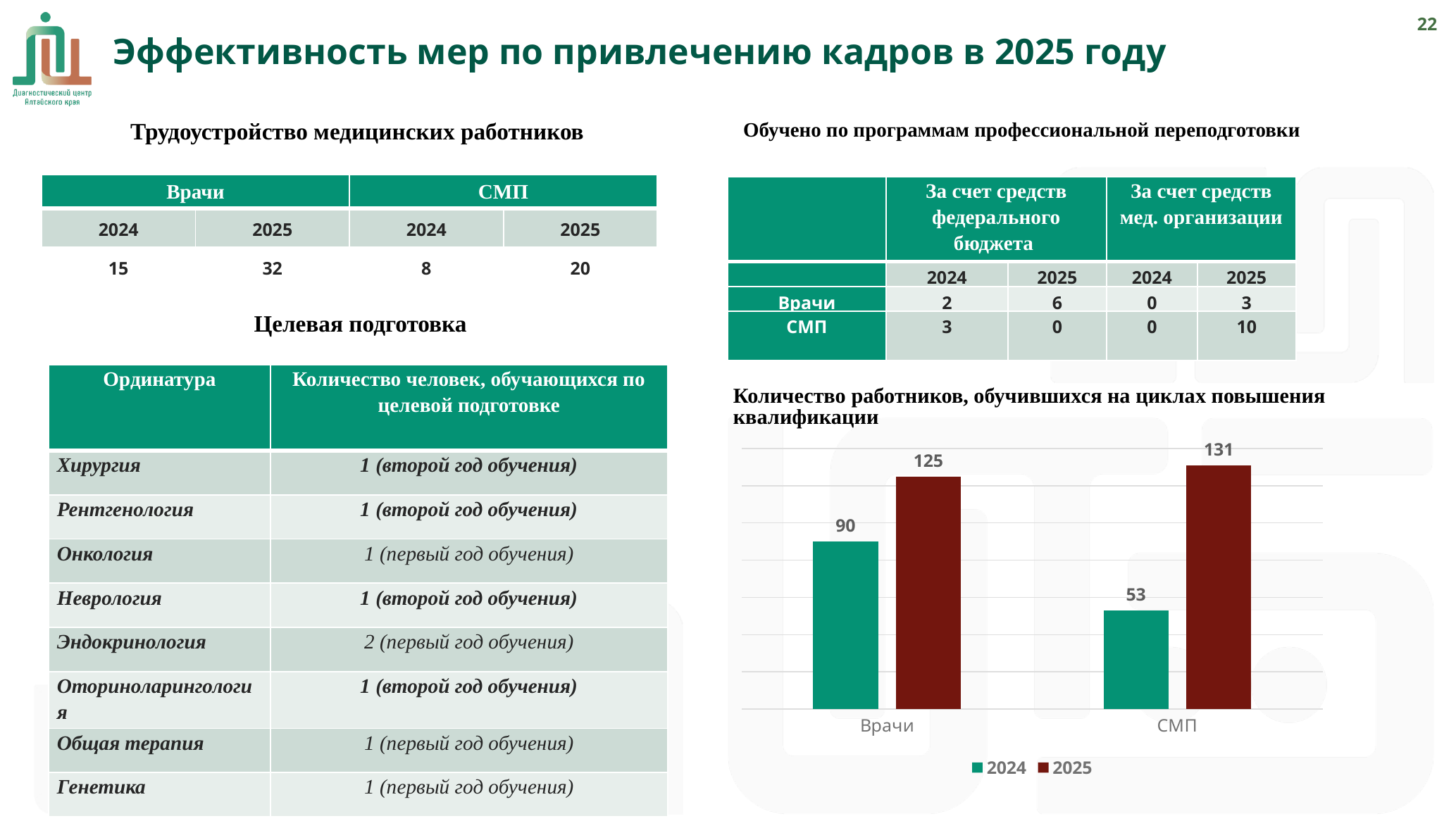
What is the difference between the 2025 and 2024 values for СМП in the chart? 78 What type of chart is shown on the slide? Bar chart What is the difference between the 2025 and 2024 values for Врачи in the chart? 35 How many categories are shown on the x axis of the chart? 2 What is the value for Врачи in 2024 in the chart? 90 How many series does the chart legend list? 2 In the chart, which is larger: the 2024 value for Врачи or the 2024 value for СМП? Врачи What is the value for СМП in 2025 in the chart? 131 Which bar in the chart has the lowest value? СМП, 2024 What is the value for Врачи in 2025 in the chart? 125 Which bar in the chart has the highest value? СМП, 2025 What is the value for СМП in 2024 in the chart? 53